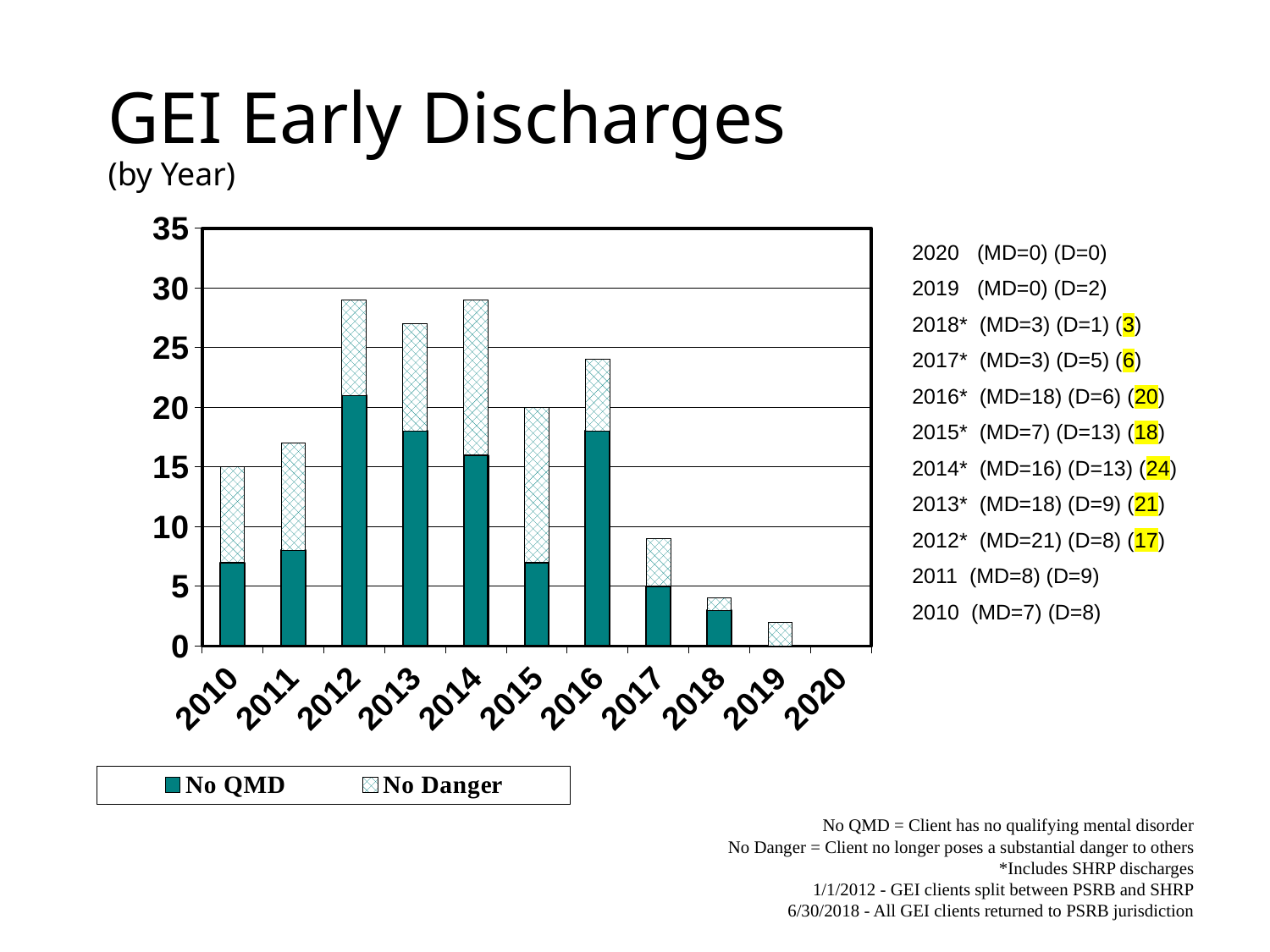
Which year has the lowest total early discharges? 2020 How many years are shown on the x axis of the chart? 11 Is the total value for 2012 greater or less than 25? greater Do the total bar heights rise or fall from 2016 to 2020? fall What is the total height of the stacked bar for 2016? 24 What is the No QMD value for 2012? 21 Which year has the larger No QMD value, 2013 or 2015? 2013 Which year has the highest No QMD value? 2012 What is the No Danger value for 2015? 13 What kind of chart is shown on the slide? bar chart How many series does the legend list? 2 What is the difference between the No QMD and No Danger values for 2014? 3